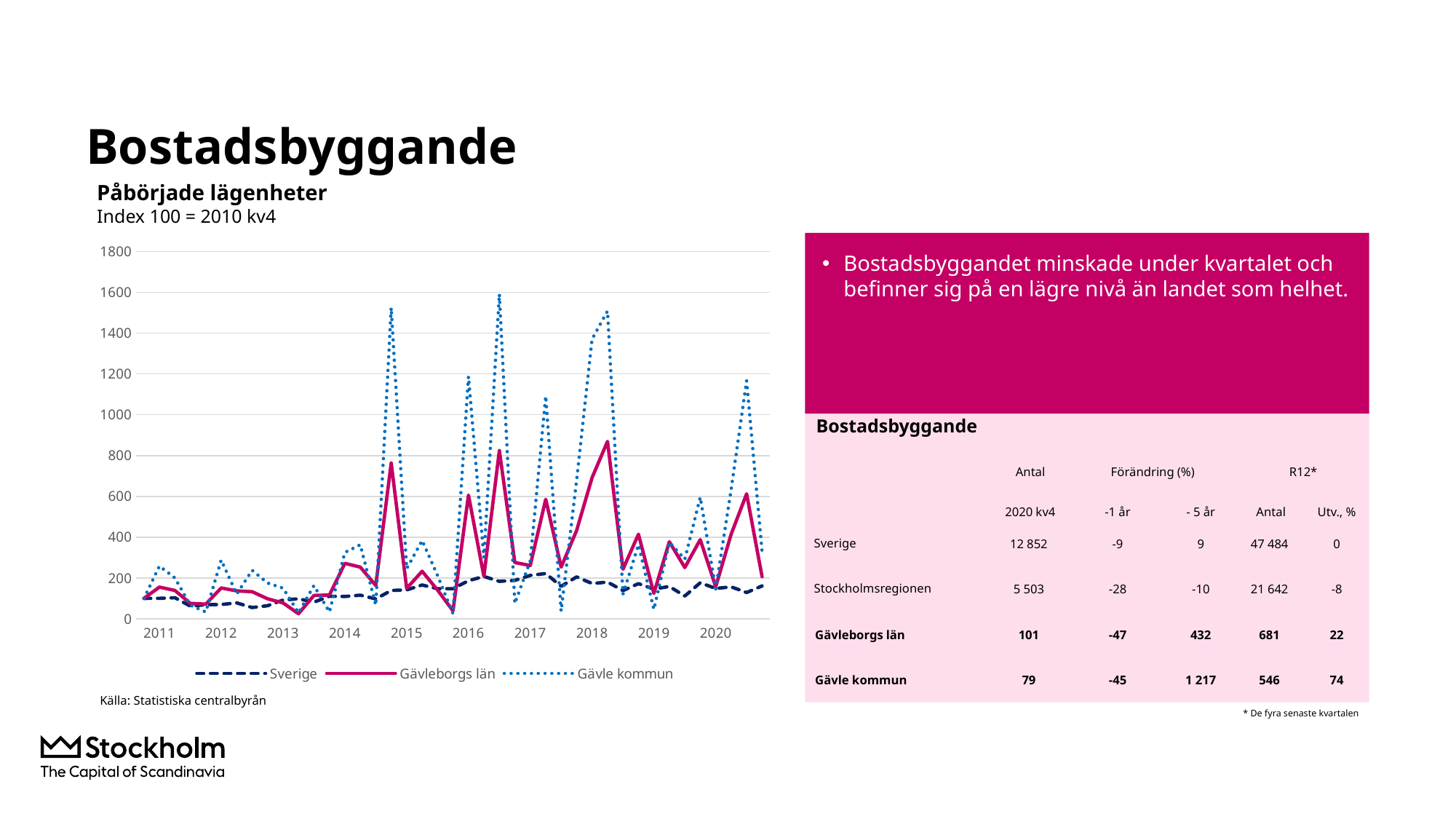
In the 'Påbörjade lägenheter' chart, at the 2018 peak, which is larger: Gävleborgs län or Sverige? Gävleborgs län In the 'Påbörjade lägenheter' chart, is the highest peak of Gävleborgs län greater or less than 600? greater Which series in the 'Påbörjade lägenheter' chart reaches the highest value? Gävle kommun How many year labels are shown on the x axis of the 'Påbörjade lägenheter' chart? 10 What kind of chart is shown under the heading 'Påbörjade lägenheter'? line chart Which series are listed in the legend of the 'Påbörjade lägenheter' chart? Sverige, Gävleborgs län, Gävle kommun How many series does the legend of the 'Påbörjade lägenheter' chart list? 3 What is the highest value shown on the y axis of the 'Påbörjade lägenheter' chart? 1800 Which series in the 'Påbörjade lägenheter' chart stays lowest overall across the period? Sverige In the 'Påbörjade lägenheter' chart, is the highest peak of Gävle kommun greater or less than 1400? greater In the 'Påbörjade lägenheter' chart, is the highest value of the Sverige series greater or less than 400? less What is the index base stated under the chart title 'Påbörjade lägenheter'? Index 100 = 2010 kv4